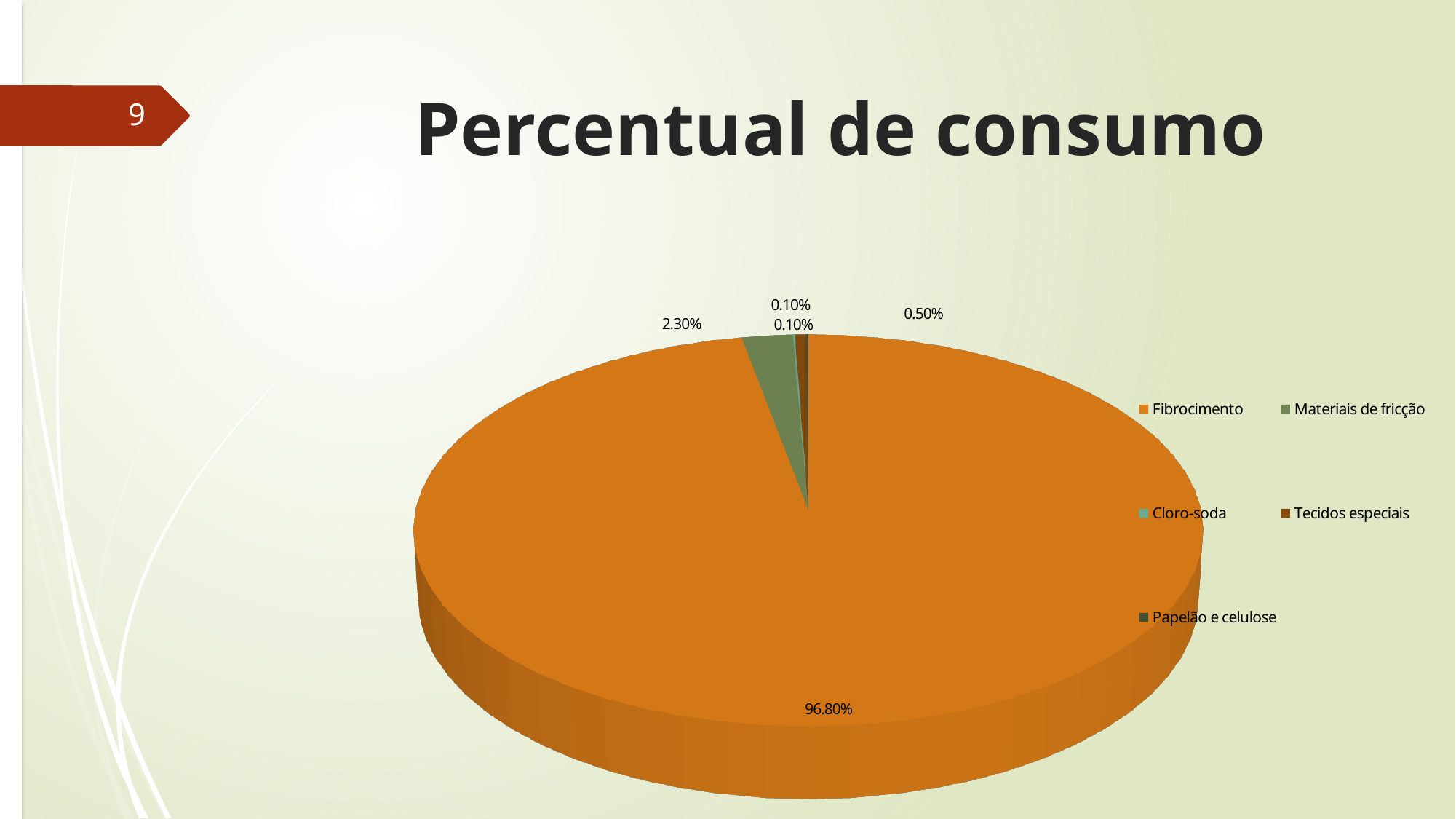
What is the smallest percentage value labelled on the pie? 0.10% What is the title of the chart? Percentual de consumo How many categories does the legend list? 5 What is the difference between the Fibrocimento share and the Materiais de fricção share? 94.50% What percentage is shown for Materiais de fricção? 2.30% What kind of chart is shown on the slide? pie chart Which is larger, the share for Fibrocimento or the share for Materiais de fricção? Fibrocimento What percentage is shown for Fibrocimento? 96.80% Which category has the largest share of the pie? Fibrocimento What colour is the Fibrocimento slice? orange How many slices are labelled with 0.10%? 2 What share of the pie does Fibrocimento represent? 96.80%